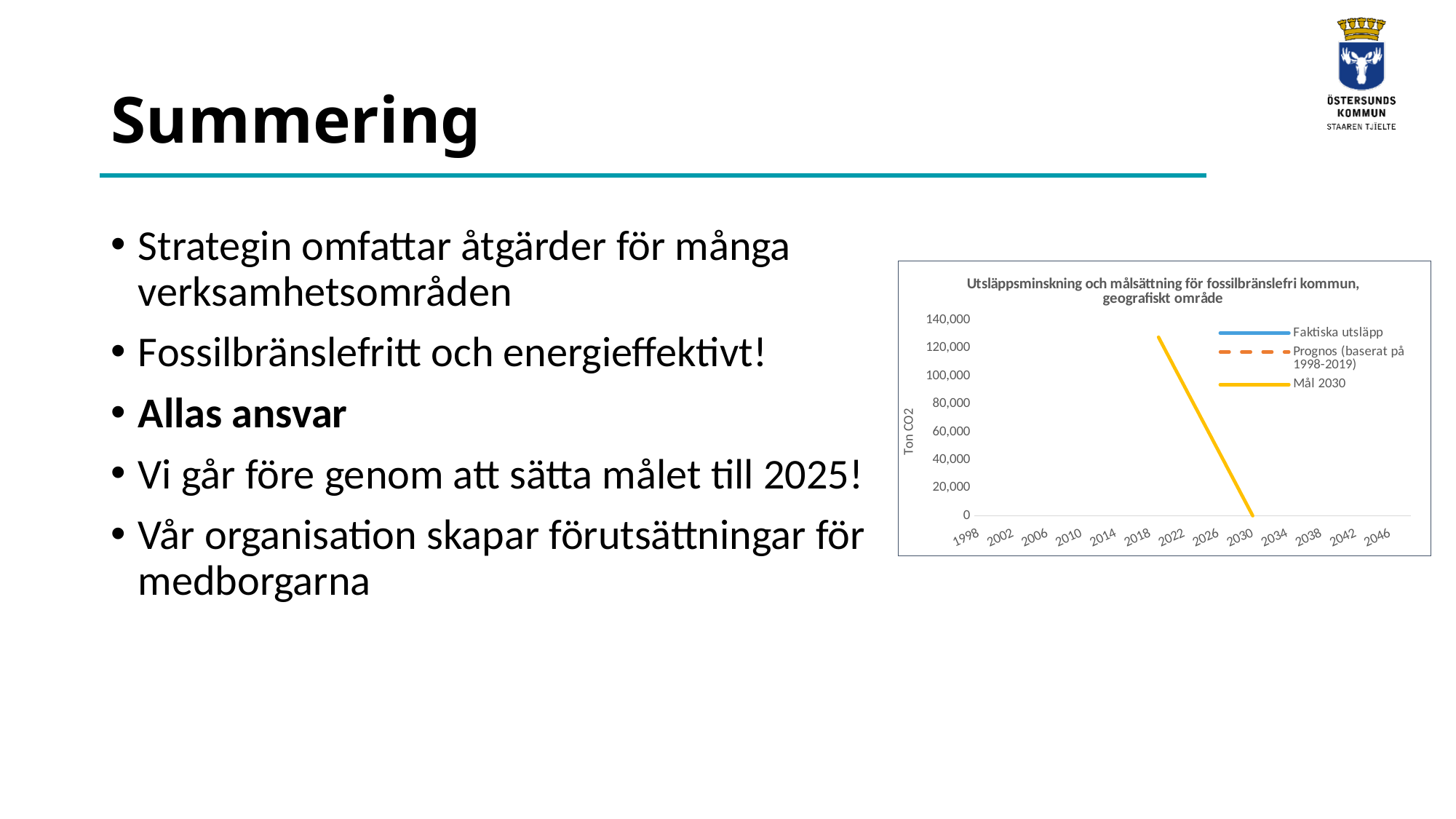
Is the starting value of the Mål 2030 line greater or less than 100,000? greater Does the Mål 2030 line rise or fall as the years increase? fall How many series does the chart legend list? 3 What value does the Mål 2030 line reach in 2030? 0 What is the label on the chart's vertical axis? Ton CO2 Is the value of the Mål 2030 line in 2026 greater or less than 60,000? less Which year is the first label on the chart's horizontal axis? 1998 What is the title of the chart? Utsläppsminskning och målsättning för fossilbränslefri kommun, geografiskt område What is the highest value shown on the chart's vertical axis? 140,000 Is the value of the Mål 2030 line in 2022 greater or less than 60,000? greater How many year labels are shown on the chart's horizontal axis? 13 What kind of chart is shown on the slide? line chart